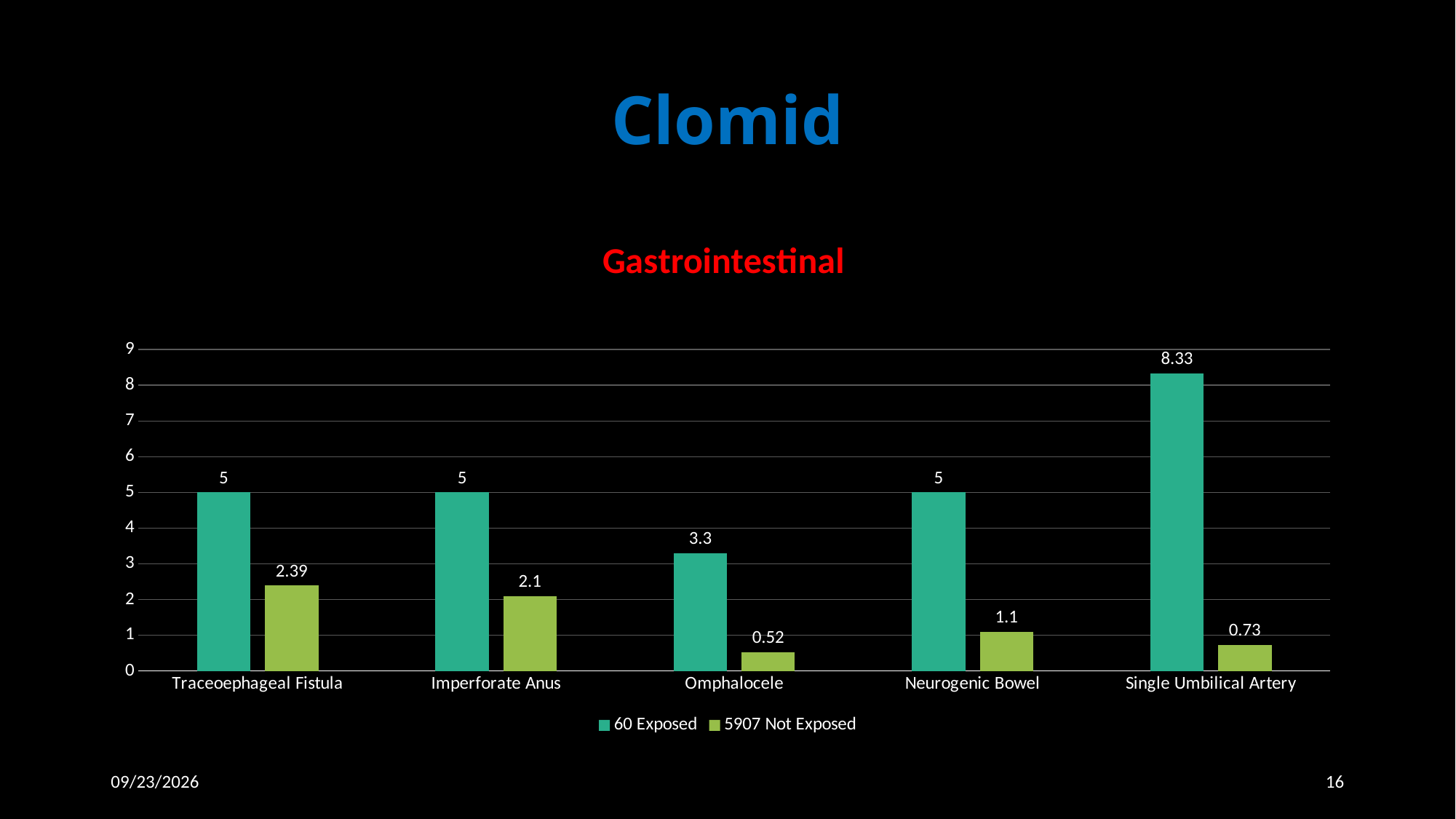
What is the difference between the 60 Exposed and 5907 Not Exposed values for Neurogenic Bowel? 3.9 What is the value for 60 Exposed for Single Umbilical Artery? 8.33 How many categories are shown on the x axis? 5 How many series does the legend list? 2 Which category has the lowest value for 5907 Not Exposed? Omphalocele Which category has the highest value for 60 Exposed? Single Umbilical Artery What is the value for 5907 Not Exposed for Traceoephageal Fistula? 2.39 What kind of chart is shown on the slide? Bar chart What is the value for 60 Exposed for Omphalocele? 3.3 What is the value for 5907 Not Exposed for Omphalocele? 0.52 Which is larger: the 5907 Not Exposed value for Imperforate Anus or for Single Umbilical Artery? Imperforate Anus What is the title of the chart? Gastrointestinal